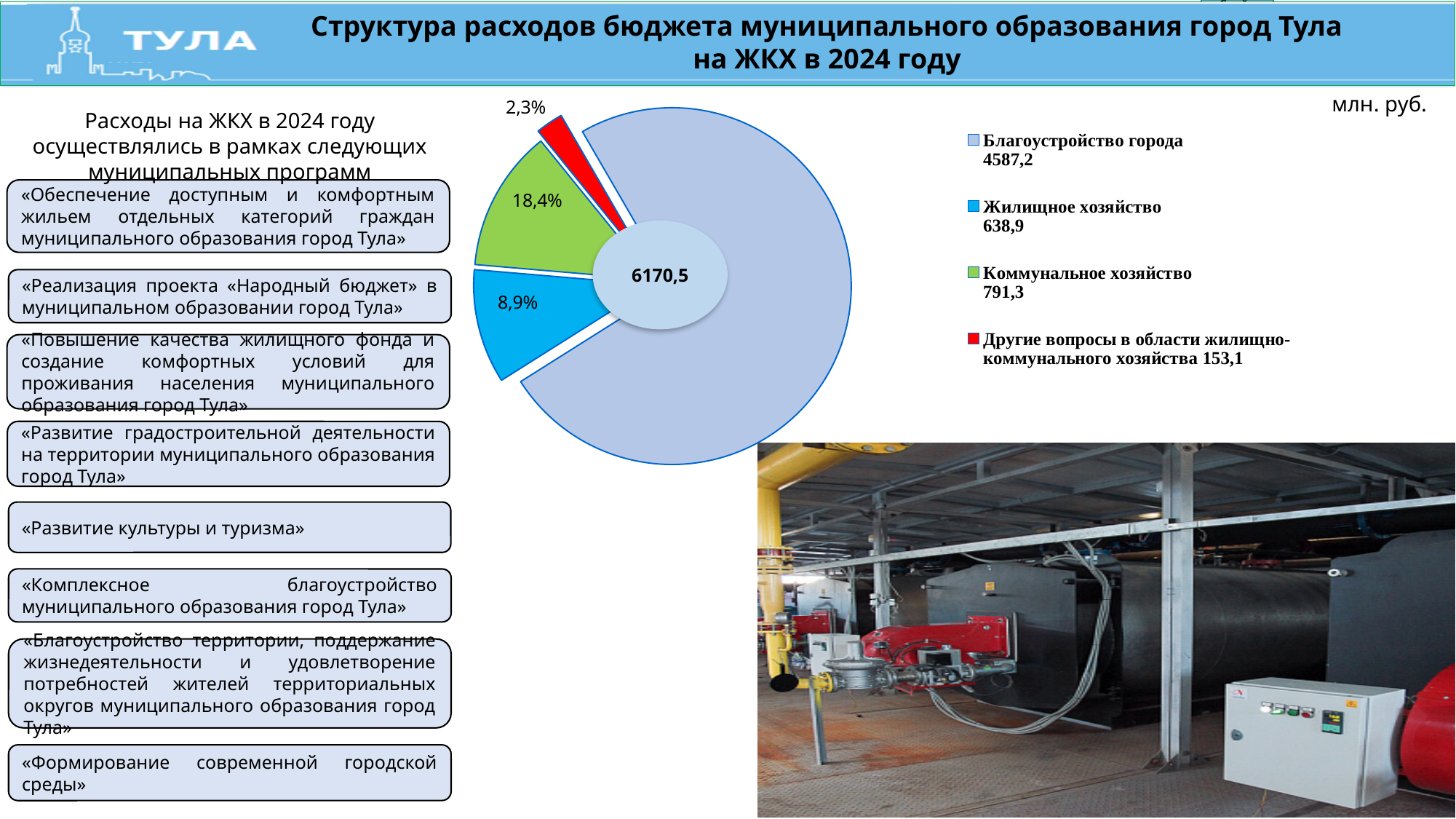
What percentage label is shown on the green slice (Коммунальное хозяйство)? 18,4% What percentage label is shown on the red slice (Другие вопросы в области жилищно-коммунального хозяйства)? 2,3% Which category has the smallest share of the pie? Другие вопросы в области жилищно-коммунального хозяйства What percentage label is shown on the blue slice (Жилищное хозяйство)? 8,9% What is the value for «Другие вопросы в области жилищно-коммунального хозяйства»? 153,1 What is the value for «Жилищное хозяйство» in the legend? 638,9 How many categories does the legend of the pie chart list? 4 What total value is printed in the centre of the pie chart? 6170,5 What is the value for «Благоустройство города» in the legend? 4587,2 Which category has the largest share of the pie? Благоустройство города What is the value for «Коммунальное хозяйство» in the legend? 791,3 What kind of chart is shown on the slide? pie chart